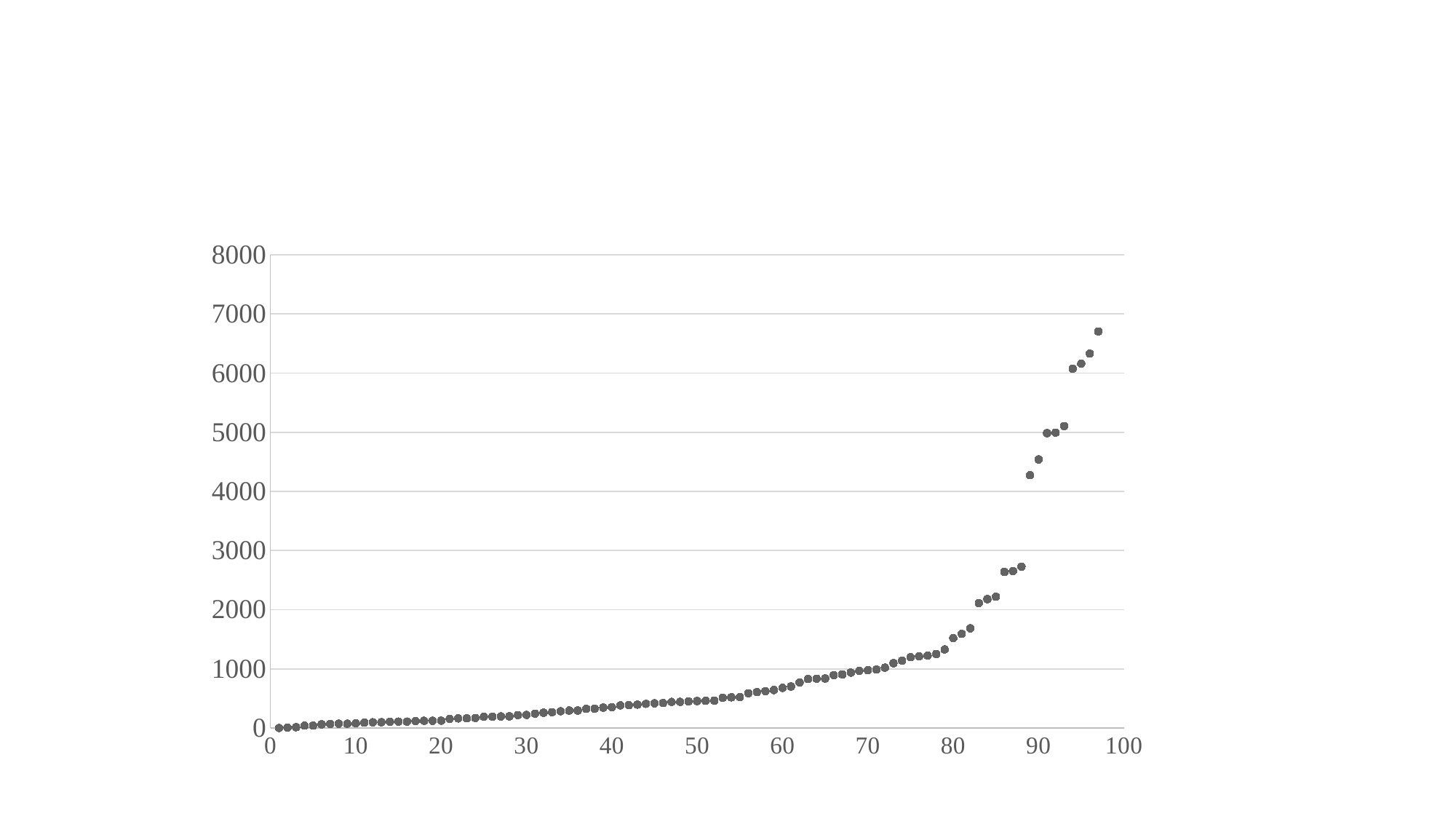
What kind of chart is shown on the slide? scatter chart What is the highest value shown on the y axis? 8000 Is the value of the point at x = 80 greater or less than 1000? greater Is the value of the point at x = 60 greater or less than 1000? less Which of the points at x = 20 and x = 90 has the larger value? x = 90 Is the value of the point at x = 50 greater or less than 1000? less Do the plotted values rise or fall as the x value increases? rise What is the highest value shown on the x axis? 100